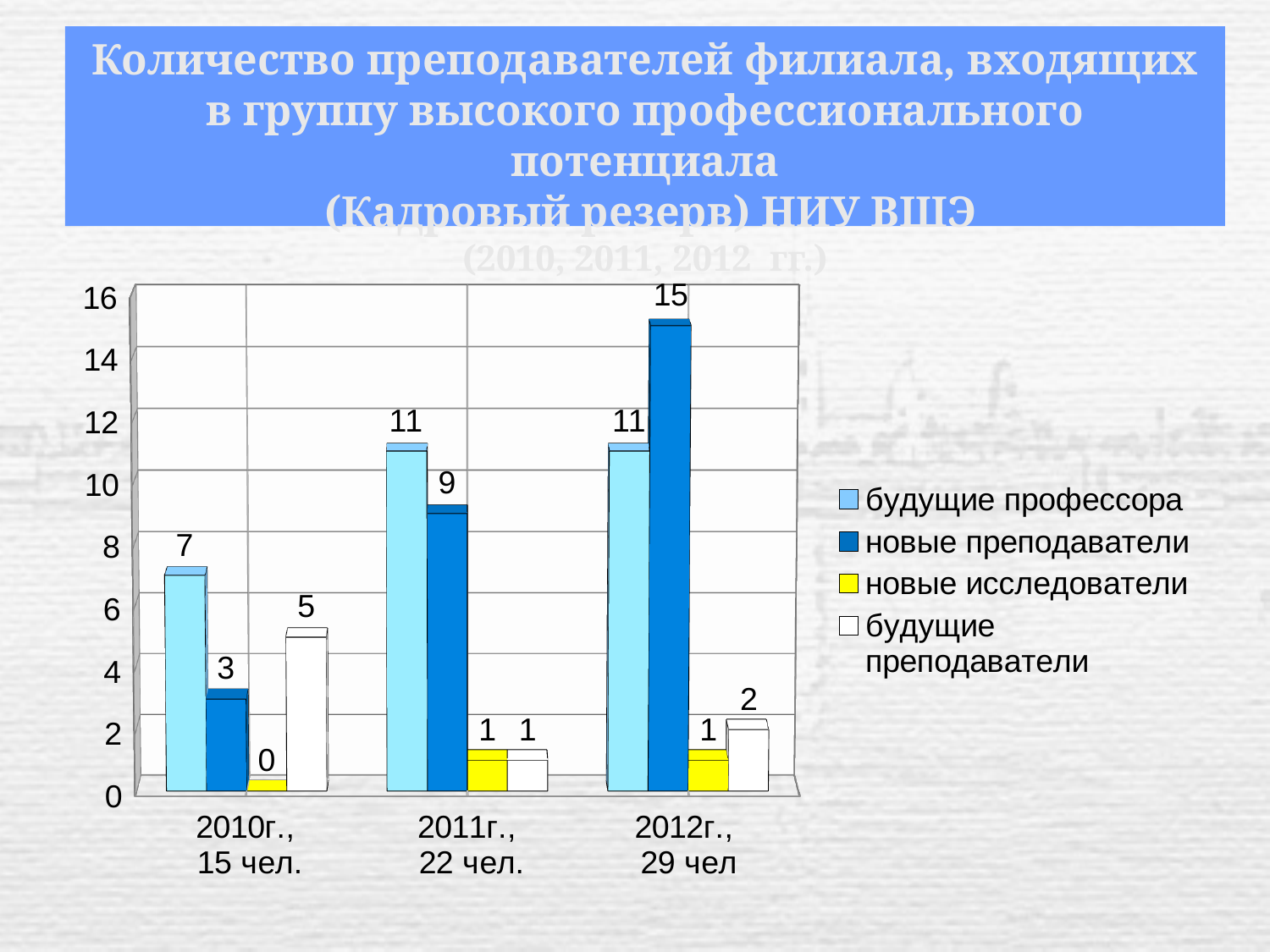
How many year categories are shown on the x axis? 3 Which year has the lowest value for «новые исследователи»? 2010г. Does the value for «новые преподаватели» rise or fall from 2010г. to 2012г.? rise Which year has the highest value for «новые преподаватели»? 2012г. What is the value for «новые исследователи» in 2011г.? 1 What is the value for «будущие профессора» in 2010г.? 7 How many series does the legend list? 4 What is the value for «новые преподаватели» in 2012г.? 15 What is the value for «будущие преподаватели» in 2010г.? 5 Which is larger in 2011г.: «будущие профессора» or «новые преподаватели»? будущие профессора What kind of chart is shown on the slide? bar chart What is the difference between «новые преподаватели» in 2012г. and in 2011г.? 6